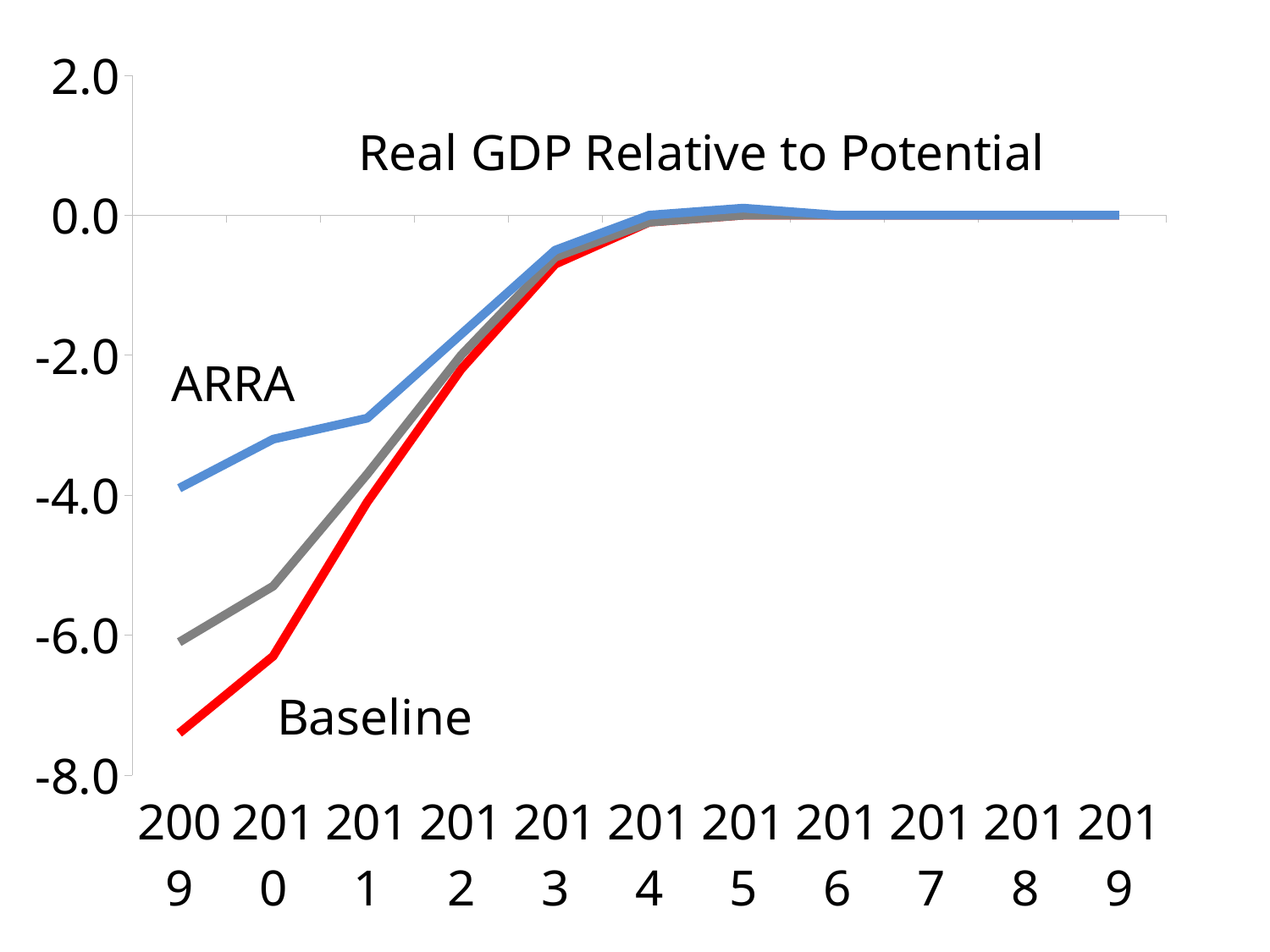
In 2009, which line is higher, ARRA or Baseline? ARRA How many years are shown on the x axis of the chart? 11 In which year is the ARRA line at its lowest value? 2009 What kind of chart is shown on the slide? line chart Does the Baseline line rise or fall from 2009 to 2015? rise In which year is the Baseline line at its lowest value? 2009 Is the value for Baseline in 2009 greater or less than -6.0? less Is the value for ARRA in 2009 greater or less than -2.0? less What is the title of the chart? Real GDP Relative to Potential How many lines are plotted on the chart? 3 Is the value for Baseline in 2010 greater or less than -4.0? less Does the ARRA line rise or fall from 2009 to 2013? rise